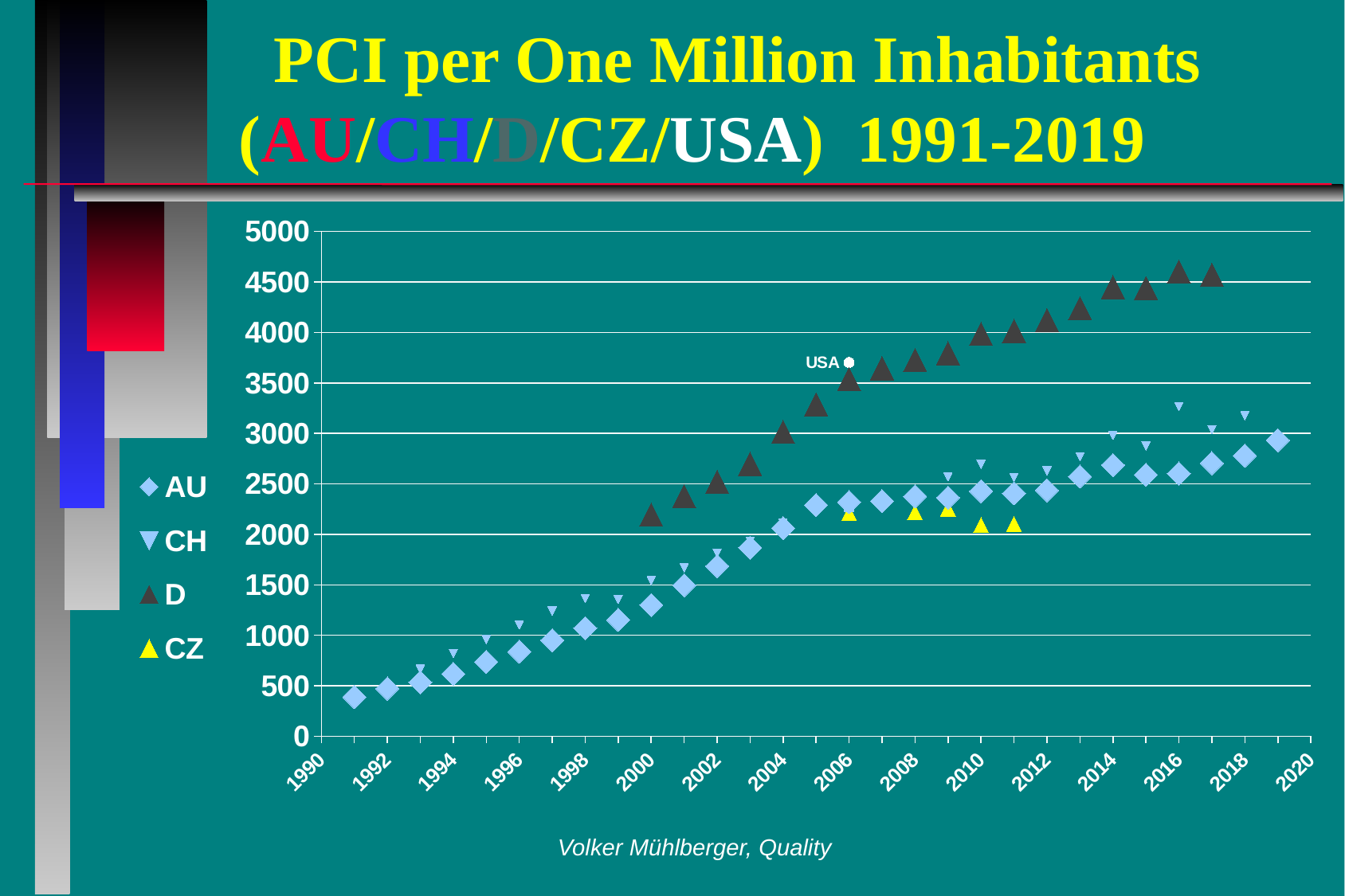
What is the title of the chart? PCI per One Million Inhabitants (AU/CH/D/CZ/USA) 1991-2019 Do the AU values rise or fall from 1991 to 2019? rise In 2010, which series has the larger value, D or AU? D Which series are listed in the legend? AU, CH, D, CZ Is the value for D in 2012 greater or less than 4000? greater What kind of chart is shown on the slide? scatter chart Is the value for AU in 2010 greater or less than 2500? less Is the USA point greater or less than 3500? greater Which series has the highest values in 2016? D How many series does the legend list? 4